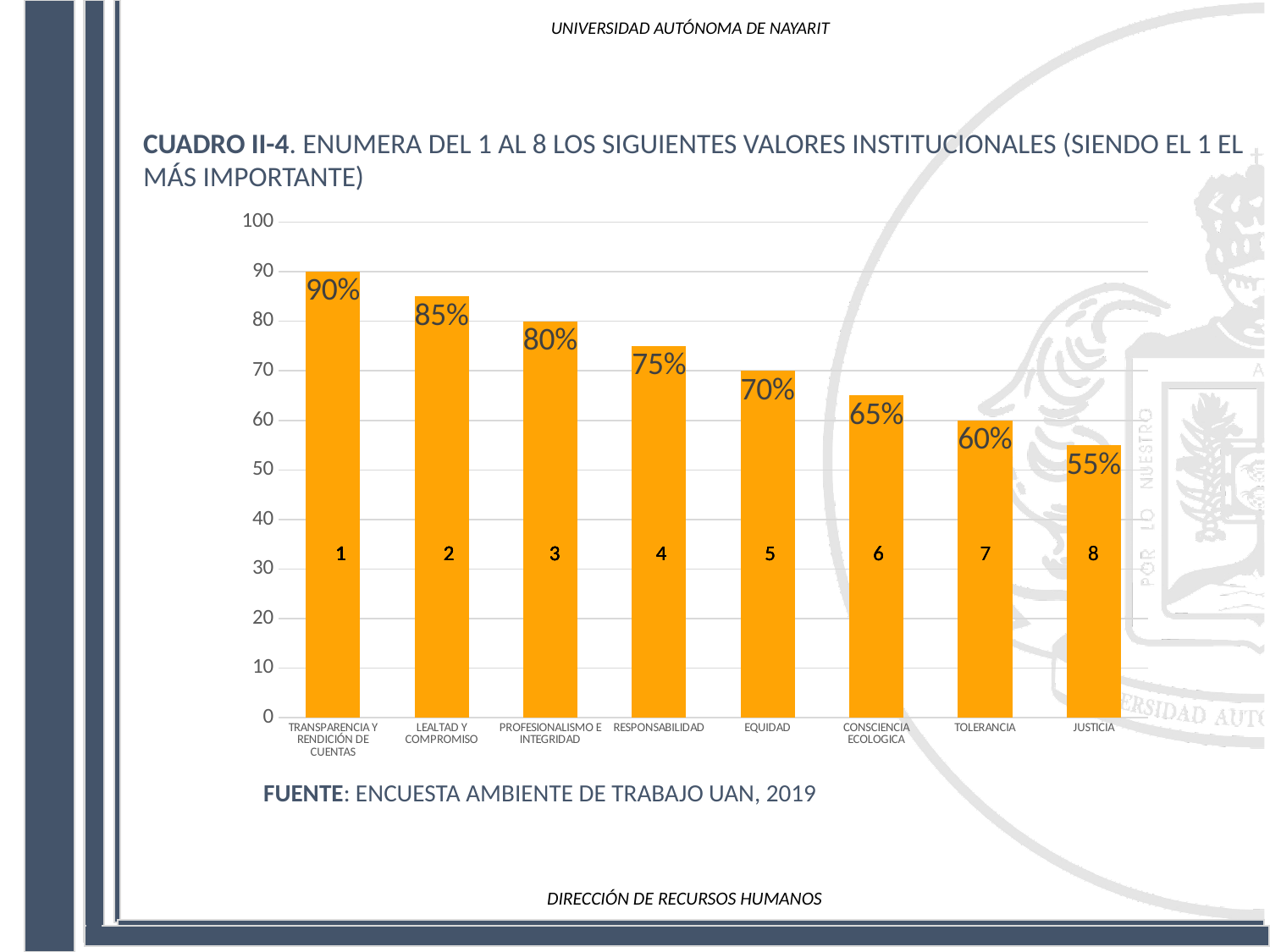
What kind of chart is shown on the slide? Bar chart What is the value for JUSTICIA? 55% Do the values rise or fall from left to right along the x axis? Fall What rank number is printed on the bar for PROFESIONALISMO E INTEGRIDAD? 3 Which category has the lowest value? JUSTICIA What is the value for EQUIDAD? 70% How many categories are shown in the chart? 8 What is the difference between the values for LEALTAD Y COMPROMISO and TOLERANCIA? 25% What is the value for TRANSPARENCIA Y RENDICIÓN DE CUENTAS? 90% Which category has the highest value? TRANSPARENCIA Y RENDICIÓN DE CUENTAS What source is cited below the chart? ENCUESTA AMBIENTE DE TRABAJO UAN, 2019 Which is larger, the value for RESPONSABILIDAD or the value for CONSCIENCIA ECOLOGICA? RESPONSABILIDAD